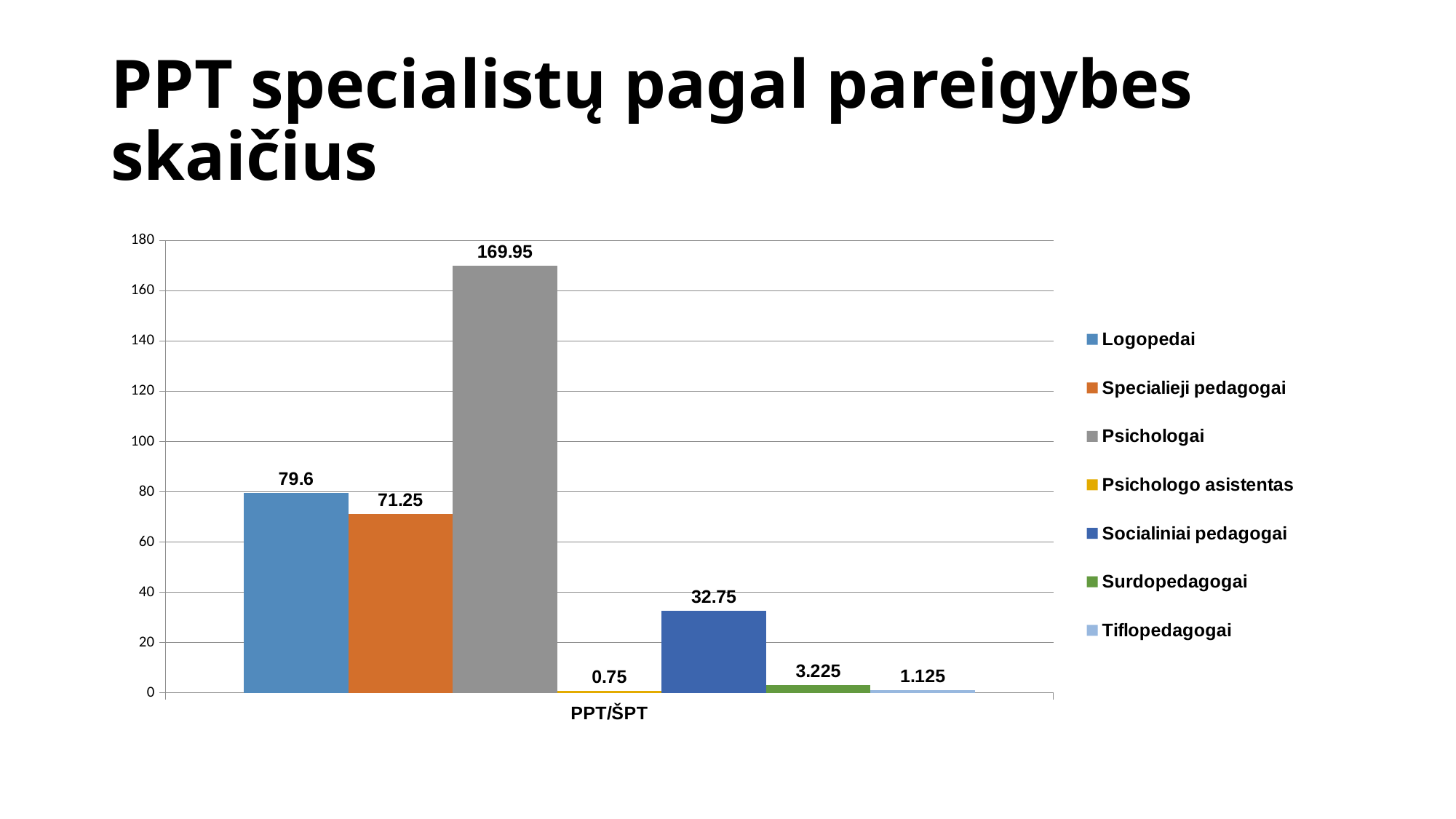
What is the value for Socialiniai pedagogai? 32.75 What is the value for Logopedai? 79.6 How many series does the legend list? 7 Which is larger, the value for Surdopedagogai or the value for Tiflopedagogai? Surdopedagogai Which series has the highest value? Psichologai What kind of chart is shown on the slide? bar chart What is the label on the x axis under the bars? PPT/ŠPT Which series has the lowest value? Psichologo asistentas What is the value for Psichologo asistentas? 0.75 What is the difference between the values for Logopedai and Specialieji pedagogai? 8.35 Is the value for Specialieji pedagogai greater or less than 80? less What is the value for Psichologai? 169.95